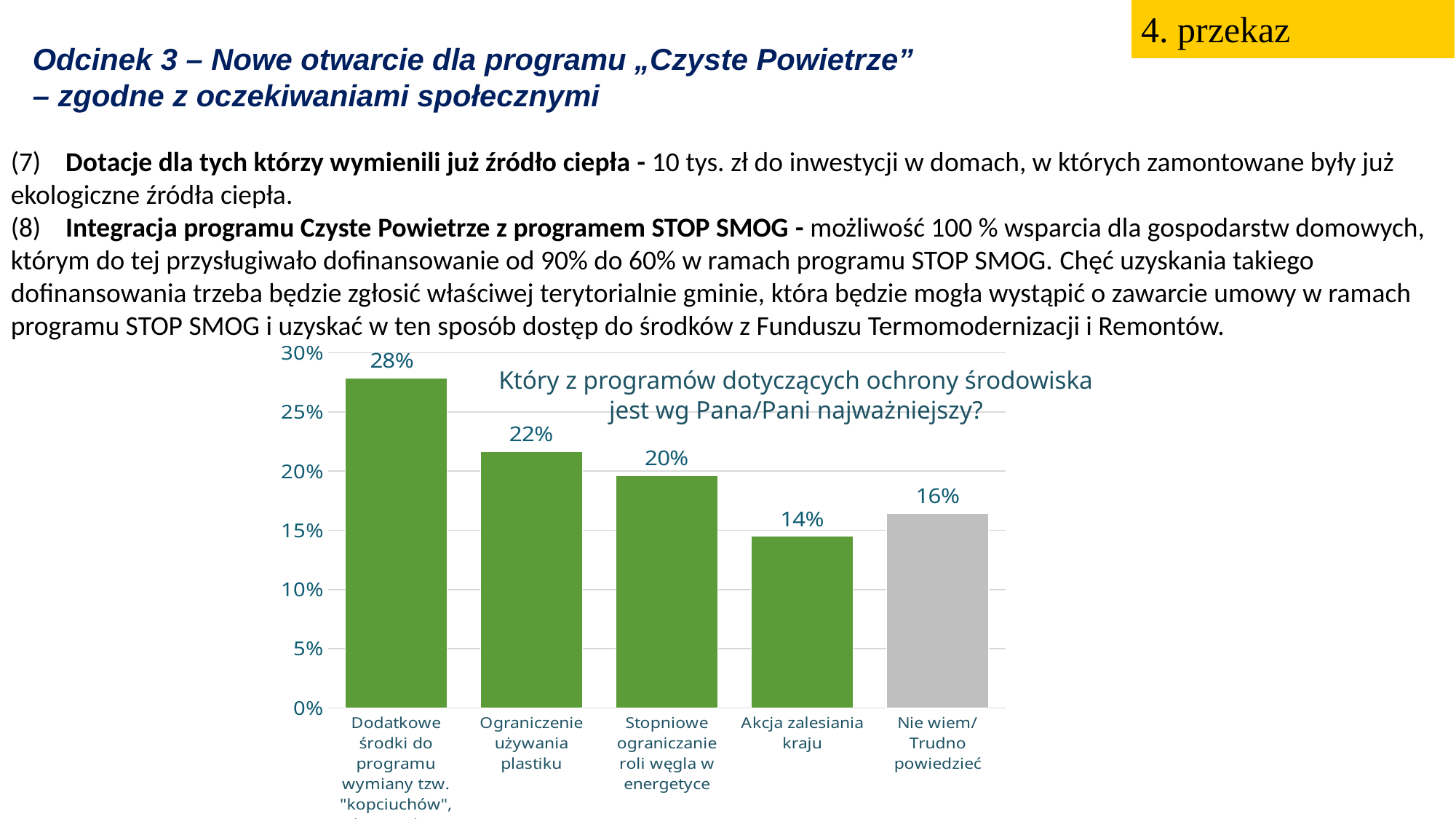
Which category has the lowest value? Akcja zalesiania kraju What type of chart is shown on the slide? bar chart Which is larger: the value for "Nie wiem/ Trudno powiedzieć" or the value for "Akcja zalesiania kraju"? Nie wiem/ Trudno powiedzieć What is the value for "Ograniczenie używania plastiku"? 22% How many categories are shown in the chart? 5 Which category has the highest value? Dodatkowe środki do programu wymiany tzw. "kopciuchów" What is the value for "Stopniowe ograniczanie roli węgla w energetyce"? 20% What is the title of the chart? Który z programów dotyczących ochrony środowiska jest wg Pana/Pani najważniejszy? What is the value for "Nie wiem/ Trudno powiedzieć"? 16% What is the difference between the values for "Ograniczenie używania plastiku" and "Akcja zalesiania kraju"? 8% What is the value for "Akcja zalesiania kraju"? 14% Which bar is coloured grey instead of green? Nie wiem/ Trudno powiedzieć